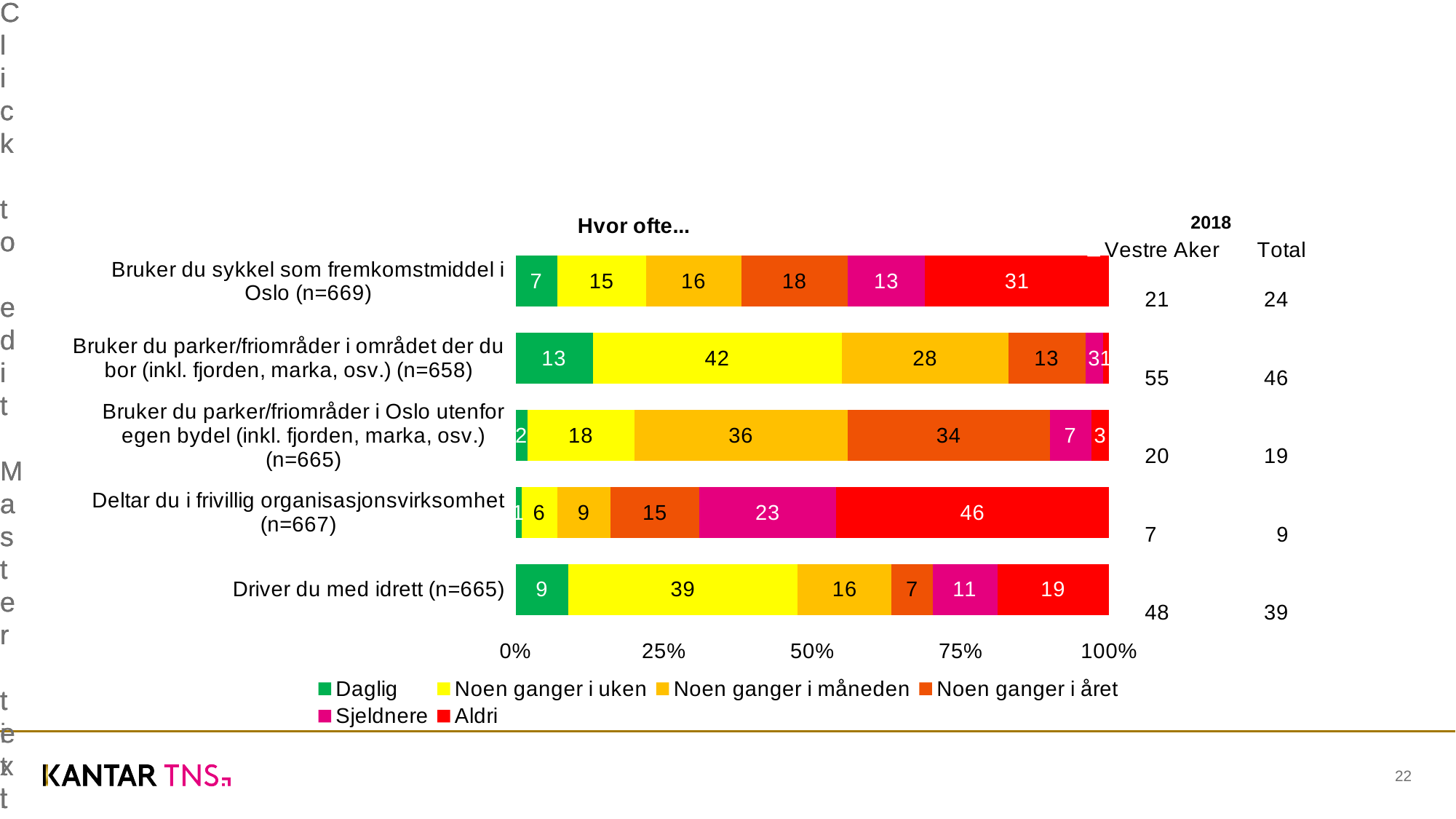
What is the "Daglig" value for "Driver du med idrett"? 9 What type of chart is shown on the slide? Stacked bar chart How many series does the legend list? 6 What is the value for "Noen ganger i uken" for "Bruker du parker/friområder i området der du bor"? 42 Which has a larger "Noen ganger i måneden" value: "Bruker du parker/friområder i Oslo utenfor egen bydel" or "Driver du med idrett"? Bruker du parker/friområder i Oslo utenfor egen bydel What is the "Sjeldnere" value for "Deltar du i frivillig organisasjonsvirksomhet"? 23 How many questions (bars) are shown in the chart? 5 What percentage answered "Aldri" to "Bruker du sykkel som fremkomstmiddel i Oslo"? 31 Which question has the highest "Aldri" share? Deltar du i frivillig organisasjonsvirksomhet Which question has the lowest "Daglig" share? Deltar du i frivillig organisasjonsvirksomhet What is the difference between the "Aldri" values for "Bruker du sykkel som fremkomstmiddel i Oslo" and "Driver du med idrett"? 12 What is the title of the chart? Hvor ofte...